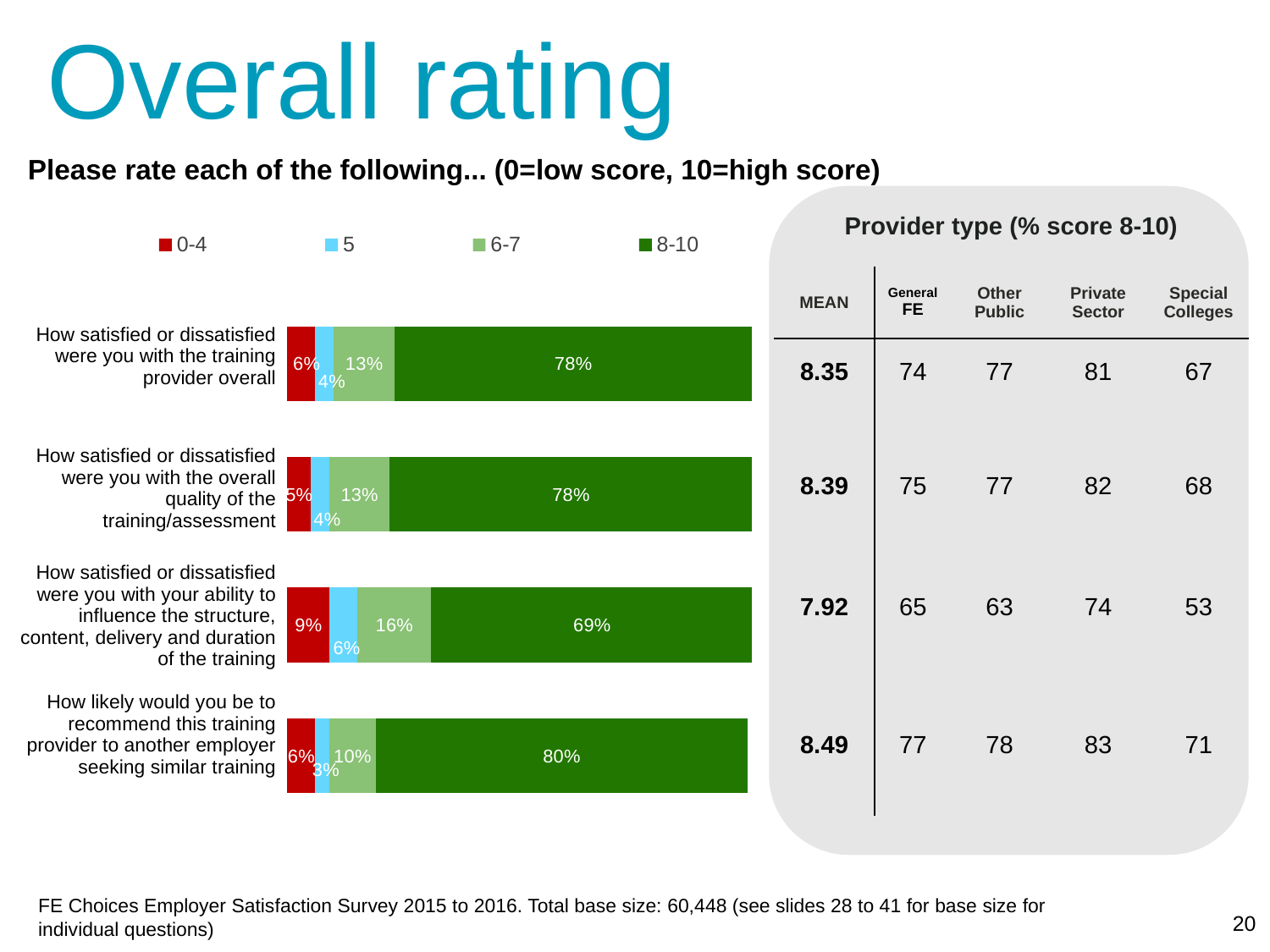
What kind of chart is shown on the slide? Stacked bar chart How many question categories are plotted in the chart? 4 What percentage scored 0-4 for 'How satisfied or dissatisfied were you with your ability to influence the structure, content, delivery and duration of the training'? 9% Which is larger: the 6-7 percentage for 'ability to influence the structure, content, delivery and duration of the training' or for 'How likely would you be to recommend this training provider'? Ability to influence the structure, content, delivery and duration of the training What is the difference between the 8-10 percentage for 'How likely would you be to recommend this training provider' and for 'ability to influence the structure, content, delivery and duration of the training'? 11% What percentage scored 8-10 for 'How likely would you be to recommend this training provider to another employer seeking similar training'? 80% How many series does the chart legend list? 4 Which question has the lowest percentage scoring 8-10? How satisfied or dissatisfied were you with your ability to influence the structure, content, delivery and duration of the training What percentage scored 6-7 for 'How satisfied or dissatisfied were you with the training provider overall'? 13% Which question has the highest percentage scoring 8-10? How likely would you be to recommend this training provider to another employer seeking similar training Which legend entry is shown in red? 0-4 What percentage scored 5 for 'How likely would you be to recommend this training provider to another employer seeking similar training'? 3%